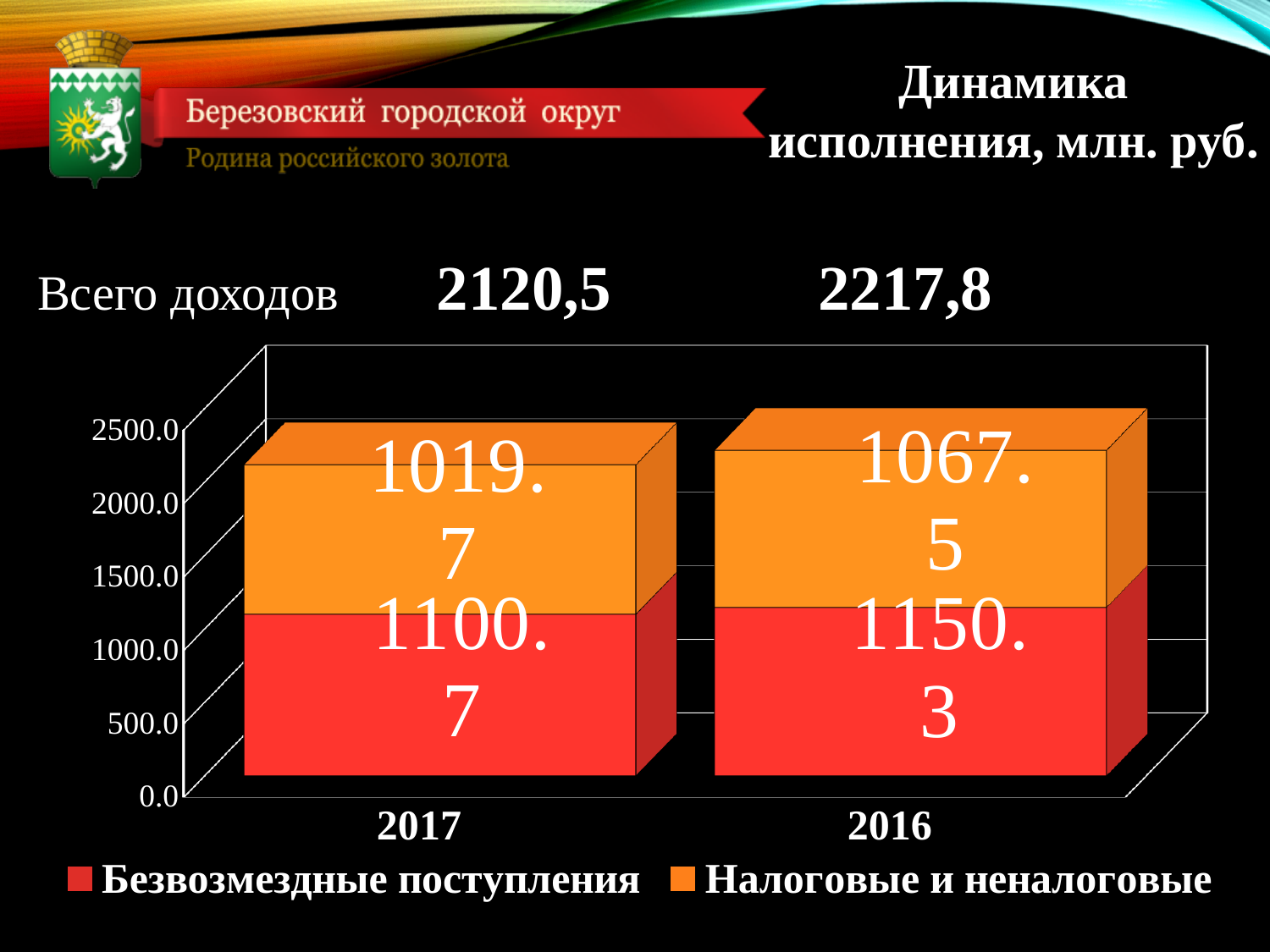
How many categories (years) are shown on the x axis? 2 What is the value of Безвозмездные поступления for 2016? 1150.3 What is the difference between Налоговые и неналоговые in 2016 and in 2017? 47.8 What kind of chart is shown on the slide? Stacked bar chart What is the value of Налоговые и неналоговые for 2017? 1019.7 What is the value of Безвозмездные поступления for 2017? 1100.7 How many series does the legend list? 2 In 2017, which series has the larger value: Безвозмездные поступления or Налоговые и неналоговые? Безвозмездные поступления What is the value of Налоговые и неналоговые for 2016? 1067.5 What is the total of the stacked bar for 2016? 2217.8 By how much does Безвозмездные поступления in 2016 exceed the value in 2017? 49.6 Which colour represents Безвозмездные поступления in the legend? Red